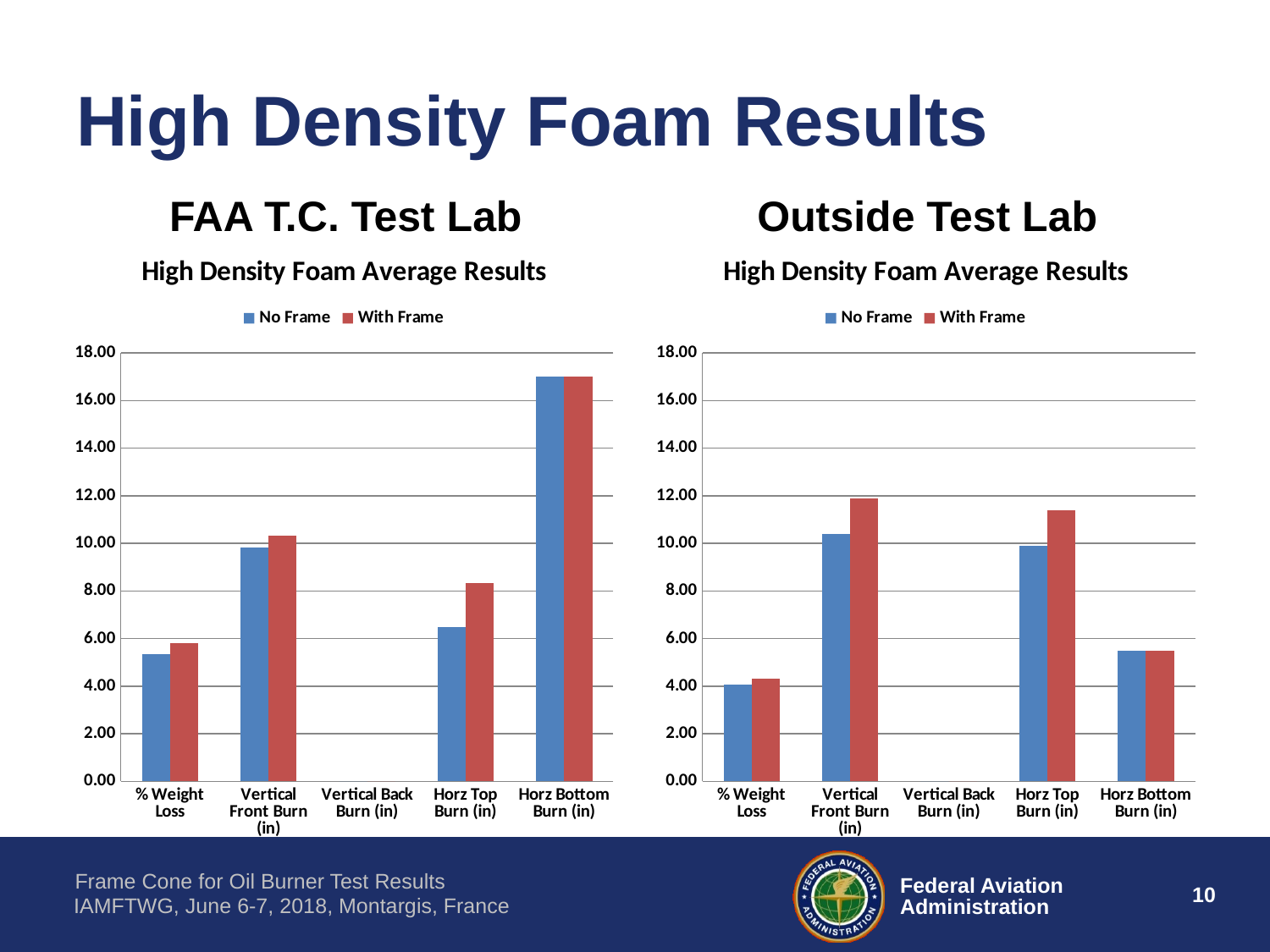
In the FAA T.C. Test Lab chart, how many series does the legend list? 2 In the FAA T.C. Test Lab chart, which category has the highest No Frame value? Horz Bottom Burn (in) In the Outside Test Lab chart, is the With Frame value for Vertical Front Burn (in) greater or less than 10.00? greater In the FAA T.C. Test Lab chart, for Horz Top Burn (in), which is larger: No Frame or With Frame? With Frame In the Outside Test Lab chart, is the No Frame value for Horz Bottom Burn (in) greater or less than 6.00? less In the Outside Test Lab chart, which category has the highest With Frame value? Vertical Front Burn (in) In the FAA T.C. Test Lab chart, is the No Frame value for Horz Bottom Burn (in) greater or less than 16.00? greater In the FAA T.C. Test Lab chart, what kind of chart is shown? Bar chart In the Outside Test Lab chart, for Horz Top Burn (in), which is larger: No Frame or With Frame? With Frame In the Outside Test Lab chart, how many categories are shown on the x axis? 5 In the Outside Test Lab chart, what colour represents the With Frame series? Red